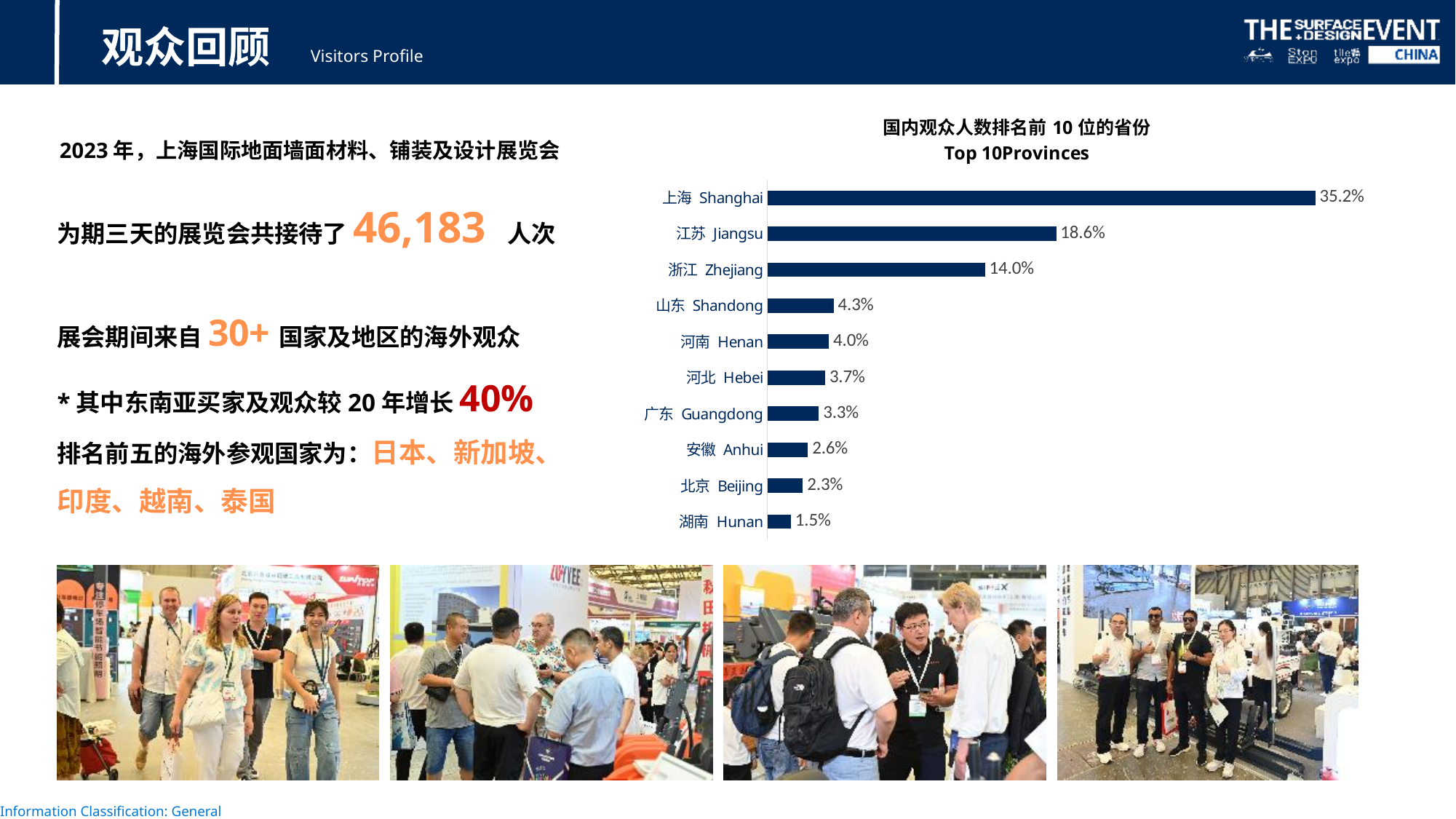
What is the difference between the values for Zhejiang and Shandong in the Top 10 Provinces chart? 9.7% What kind of chart is the Top 10 Provinces chart? Bar chart What is the difference between the values for Shanghai and Jiangsu in the Top 10 Provinces chart? 16.6% Which province has the lowest value in the Top 10 Provinces chart? Hunan Which province has the highest value in the Top 10 Provinces chart? Shanghai Which has a larger value in the Top 10 Provinces chart, Beijing or Henan? Henan How many provinces are shown in the Top 10 Provinces chart? 10 What is the value for Guangdong in the Top 10 Provinces chart? 3.3% What is the value for Zhejiang in the Top 10 Provinces chart? 14.0% Which has a larger value in the Top 10 Provinces chart, Hebei or Anhui? Hebei What is the value for Shanghai in the Top 10 Provinces chart? 35.2% What is the English title of the chart on the slide? Top 10Provinces